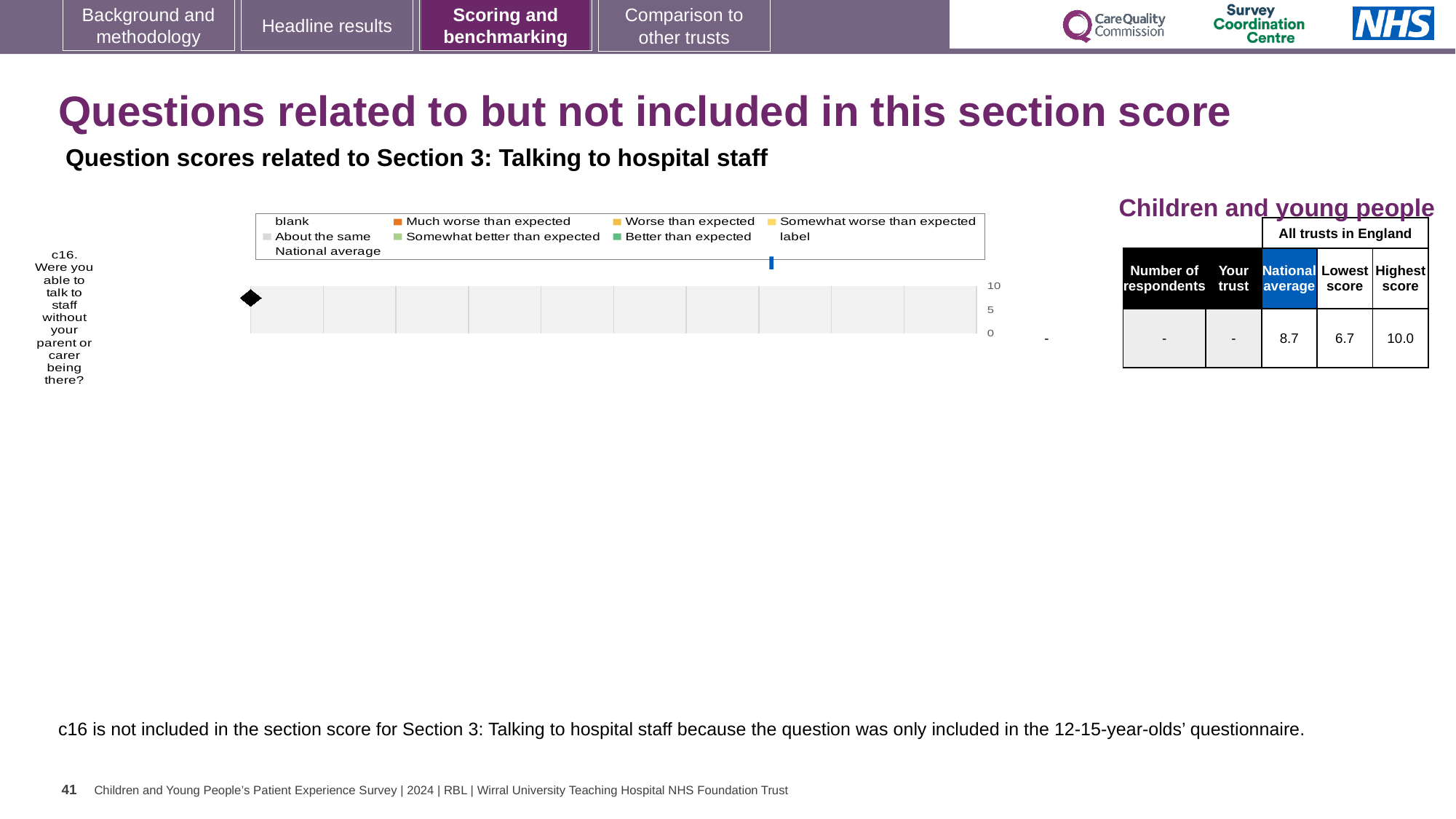
What is the highest value shown on the chart's axis? 10 How many question categories are plotted on the chart? 1 Which question is listed as the category on the chart? c16. Were you able to talk to staff without your parent or carer being there? Is a bar plotted for c16 on the chart? No What kind of chart is shown on the slide? bar chart